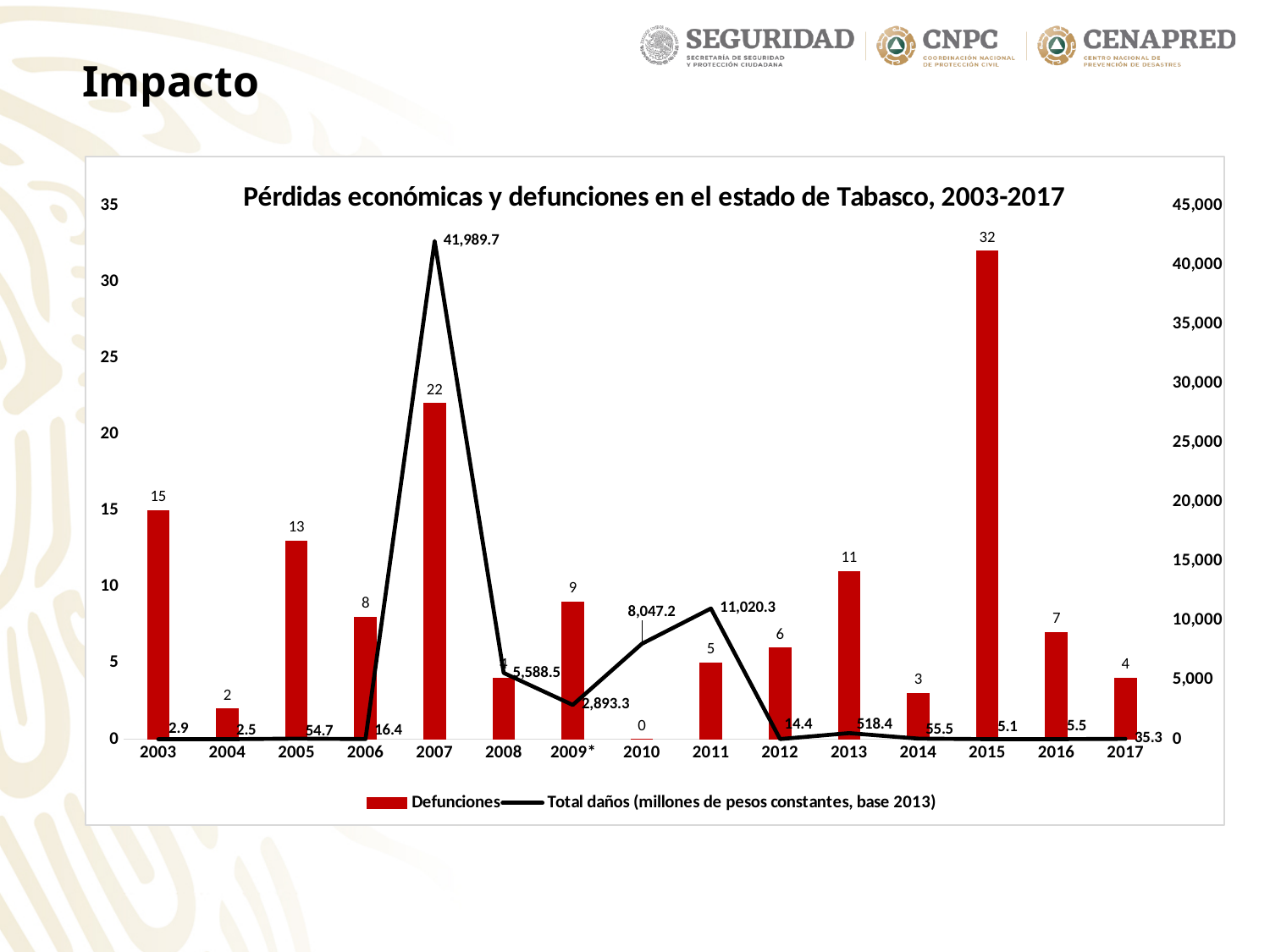
How many years are shown on the x axis? 15 What kind of chart is shown? Combined bar and line chart What is the value of Total daños in 2009*? 2,893.3 Which year has the highest number of Defunciones? 2015 What is the title of the chart? Pérdidas económicas y defunciones en el estado de Tabasco, 2003-2017 Which year has more Defunciones, 2003 or 2005? 2003 What is the difference in Defunciones between 2015 and 2007? 10 How many series does the legend list? 2 Which year has the lowest number of Defunciones? 2010 What is the value of Total daños in 2007? 41,989.7 What is the number of Defunciones in 2015? 32 Is the value of Total daños in 2011 greater or less than 10,000? greater